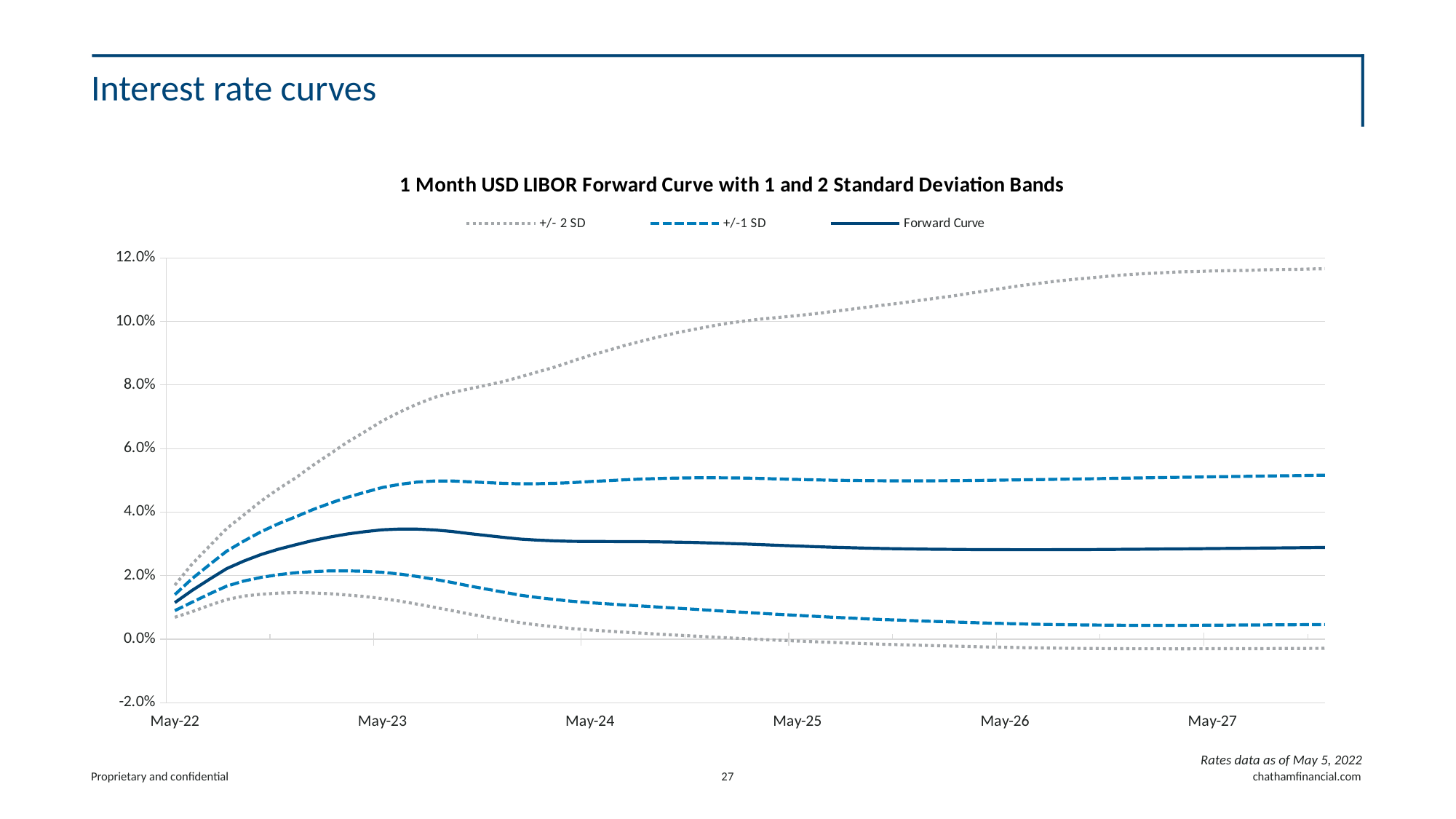
What kind of chart is shown on the slide? Line chart Is the upper +/-1 SD band value at May-25 greater or less than 4.0%? greater Which legend entry is drawn as a solid dark blue line? Forward Curve Does the lower +/-1 SD band rise or fall from May-23 to May-27? fall How many date labels are shown on the x axis? 6 Does the upper +/- 2 SD band rise or fall from May-22 to May-27? rise How many series does the legend list? 3 Is the Forward Curve value at May-23 greater or less than 2.0%? greater Is the Forward Curve value at May-23 greater or less than 4.0%? less At May-27, which is higher: the Forward Curve or the upper +/-1 SD band? upper +/-1 SD band What is the title of the chart? 1 Month USD LIBOR Forward Curve with 1 and 2 Standard Deviation Bands